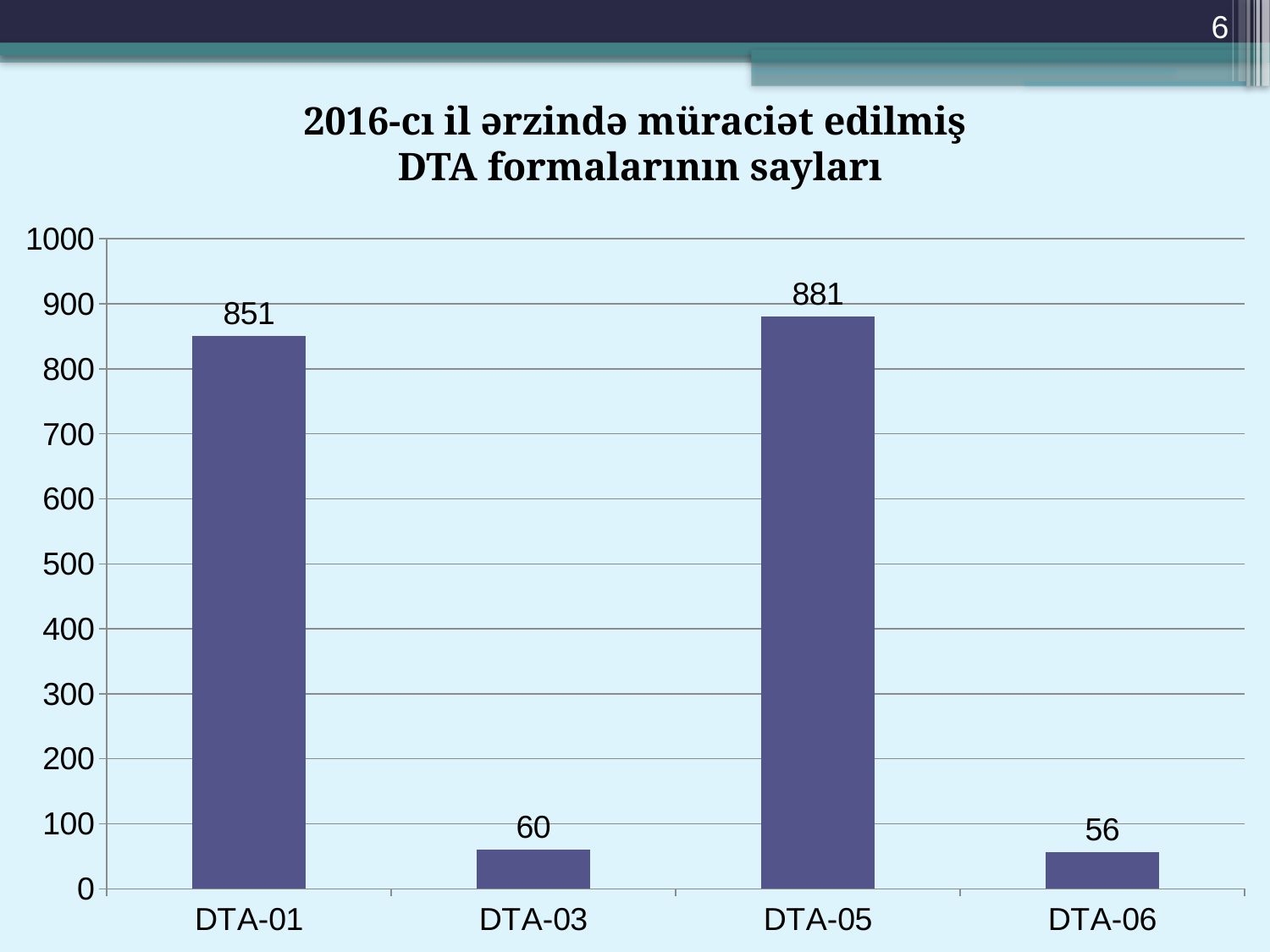
What is the value for DTA-03? 60 Which is larger, the value for DTA-01 or the value for DTA-03? DTA-01 What is the value for DTA-01? 851 What is the value for DTA-06? 56 Which category has the lowest value? DTA-06 Which category has the highest value? DTA-05 Is the value for DTA-05 greater or less than 800? greater What kind of chart is shown on the slide? bar chart How many categories are shown on the x axis? 4 What is the difference between the values for DTA-05 and DTA-01? 30 What is the value for DTA-05? 881 What is the difference between the values for DTA-03 and DTA-06? 4